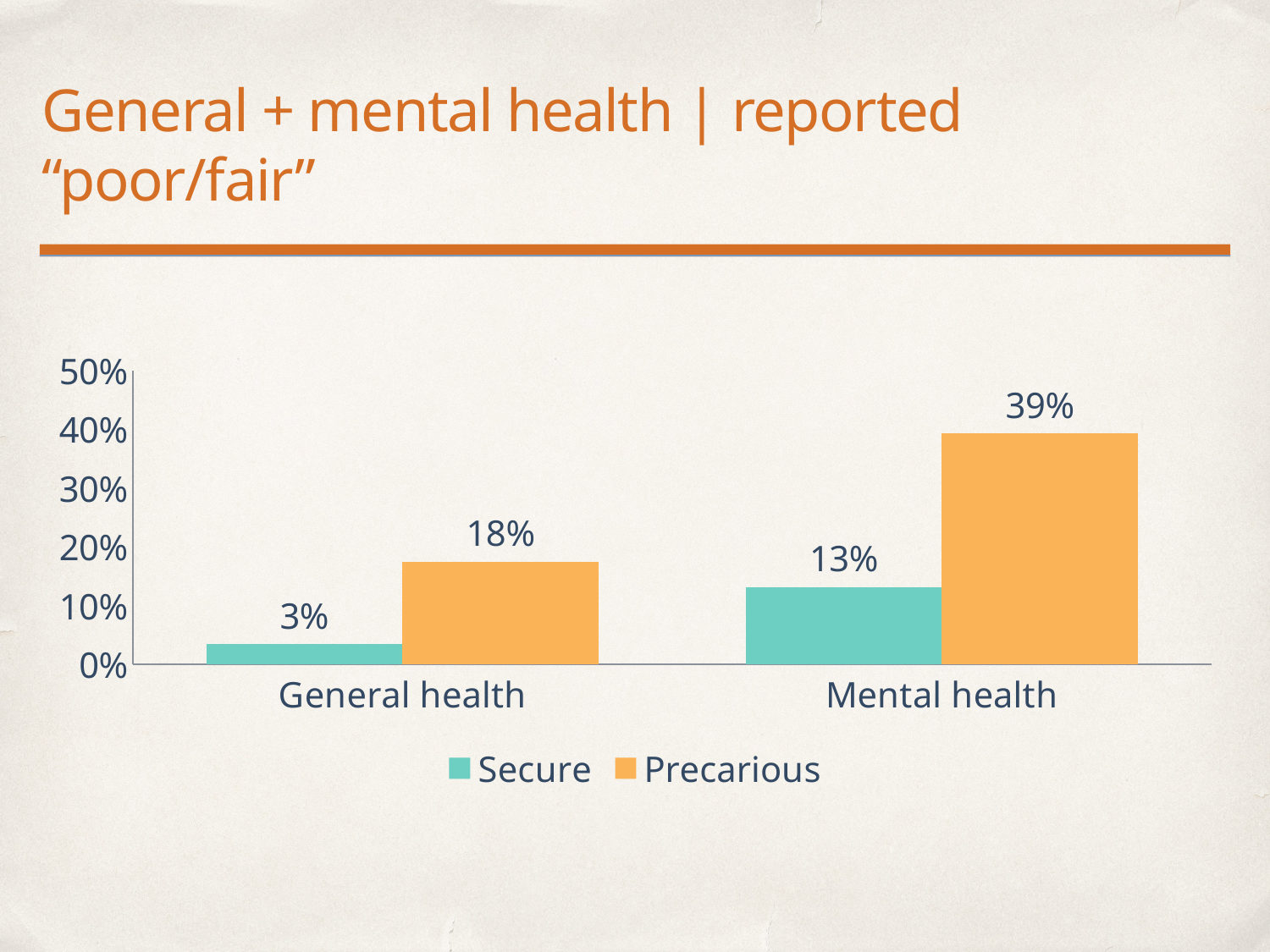
How many categories are shown on the x axis? 2 How many series does the legend list? 2 What is the difference between the Precarious and Secure values for Mental health? 26% What percentage of the Secure group reported poor/fair general health? 3% Which bar has the lowest value on the chart? Secure, General health Which bar has the highest value on the chart? Precarious, Mental health Which is larger: the Secure value for Mental health or the Precarious value for General health? Precarious value for General health What kind of chart is shown on the slide? Bar chart What is the value for Secure in the Mental health category? 13% What is the value for Precarious in the General health category? 18% What is the difference between the Precarious and Secure values for General health? 15% What percentage of the Precarious group reported poor/fair mental health? 39%